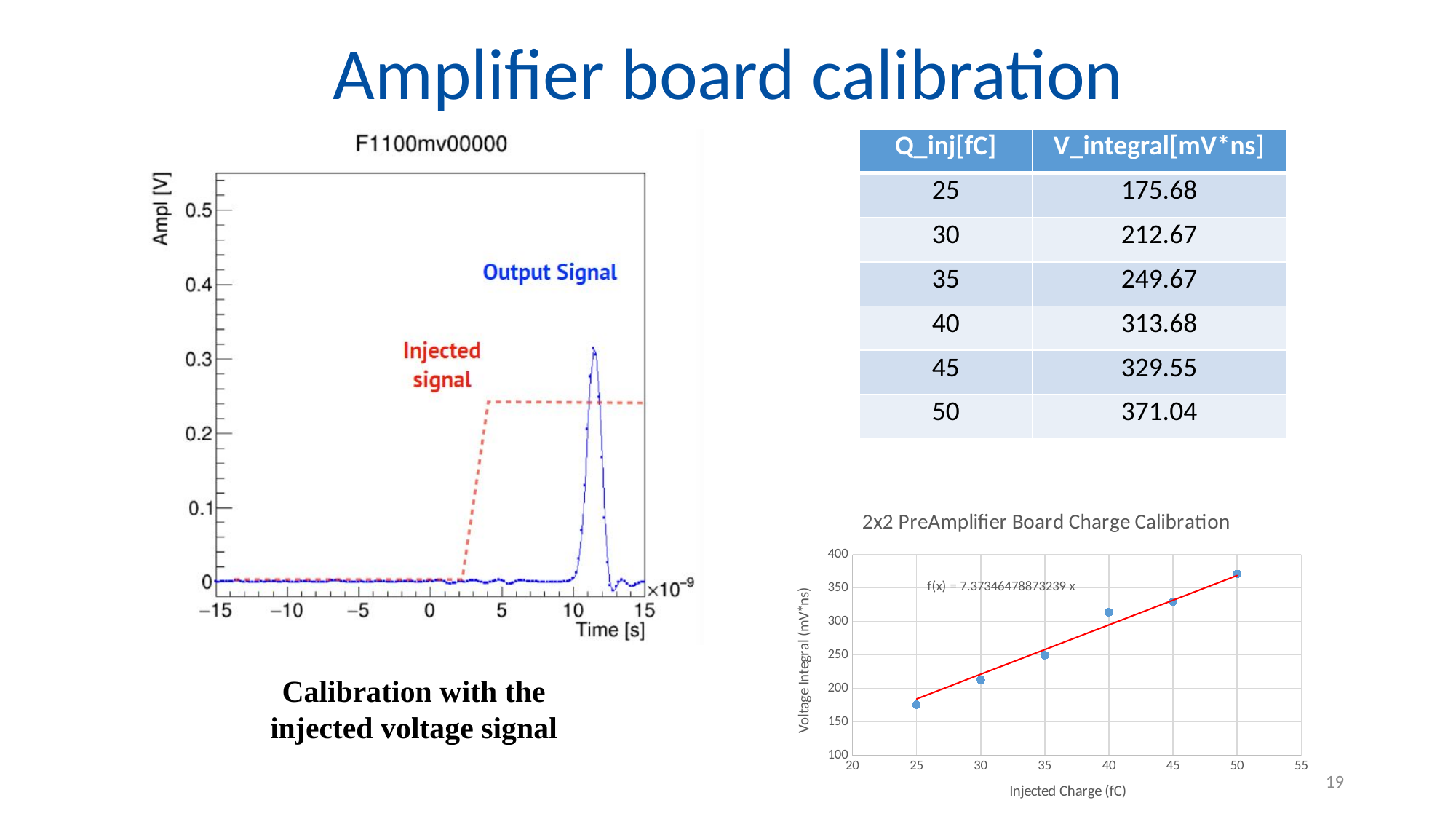
How many data points are plotted in the '2x2 PreAmplifier Board Charge Calibration' chart? 6 In the left chart titled 'F1100mv00000', is the peak of the Output Signal greater or less than 0.2 V? greater In the '2x2 PreAmplifier Board Charge Calibration' chart, which is larger: the voltage integral at 45 fC or at 35 fC? 45 fC In the '2x2 PreAmplifier Board Charge Calibration' chart, which injected charge has the lowest voltage integral? 25 In the '2x2 PreAmplifier Board Charge Calibration' chart, is the voltage integral at 40 fC greater or less than 300? greater Using the table values, what is the difference between the V_integral at 50 fC and at 25 fC in the '2x2 PreAmplifier Board Charge Calibration' chart? 195.36 In the '2x2 PreAmplifier Board Charge Calibration' chart, does the voltage integral rise or fall as the injected charge increases? rise In the '2x2 PreAmplifier Board Charge Calibration' chart, which injected charge has the highest voltage integral? 50 According to the table, what is the V_integral value for Q_inj of 50 fC plotted in the '2x2 PreAmplifier Board Charge Calibration' chart? 371.04 What fitted function is shown on the '2x2 PreAmplifier Board Charge Calibration' chart? f(x) = 7.37346478873239 x In the '2x2 PreAmplifier Board Charge Calibration' chart, is the voltage integral at 25 fC greater or less than 200? less What kind of chart is the '2x2 PreAmplifier Board Charge Calibration' chart? scatter chart